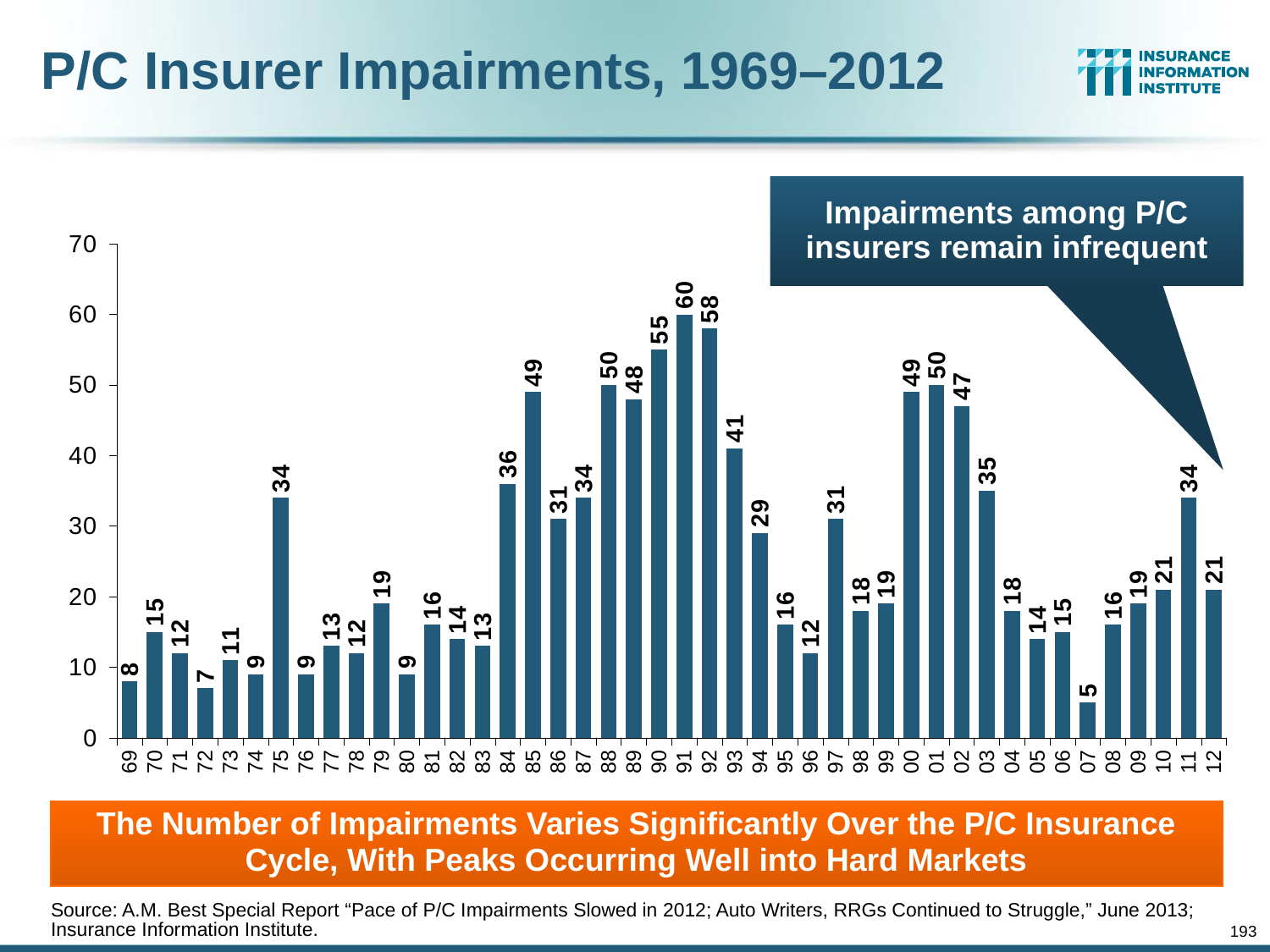
Which year had more impairments, 1985 or 2002? 1985 What is the number of impairments shown for 2012? 21 What is the number of P/C insurer impairments shown for 1991? 60 What is the difference between the impairments in 2001 and 2012? 29 What type of chart is shown on the slide? Bar chart Is the value for 1990 greater or less than 50? greater How many years (bars) are plotted in the chart? 44 What is the difference between the impairments in 1991 and 1992? 2 Which year has the lowest number of impairments? 2007 Which year has the highest number of impairments? 1991 What is the title of the chart on the slide? P/C Insurer Impairments, 1969–2012 What is the number of impairments shown for 2007? 5